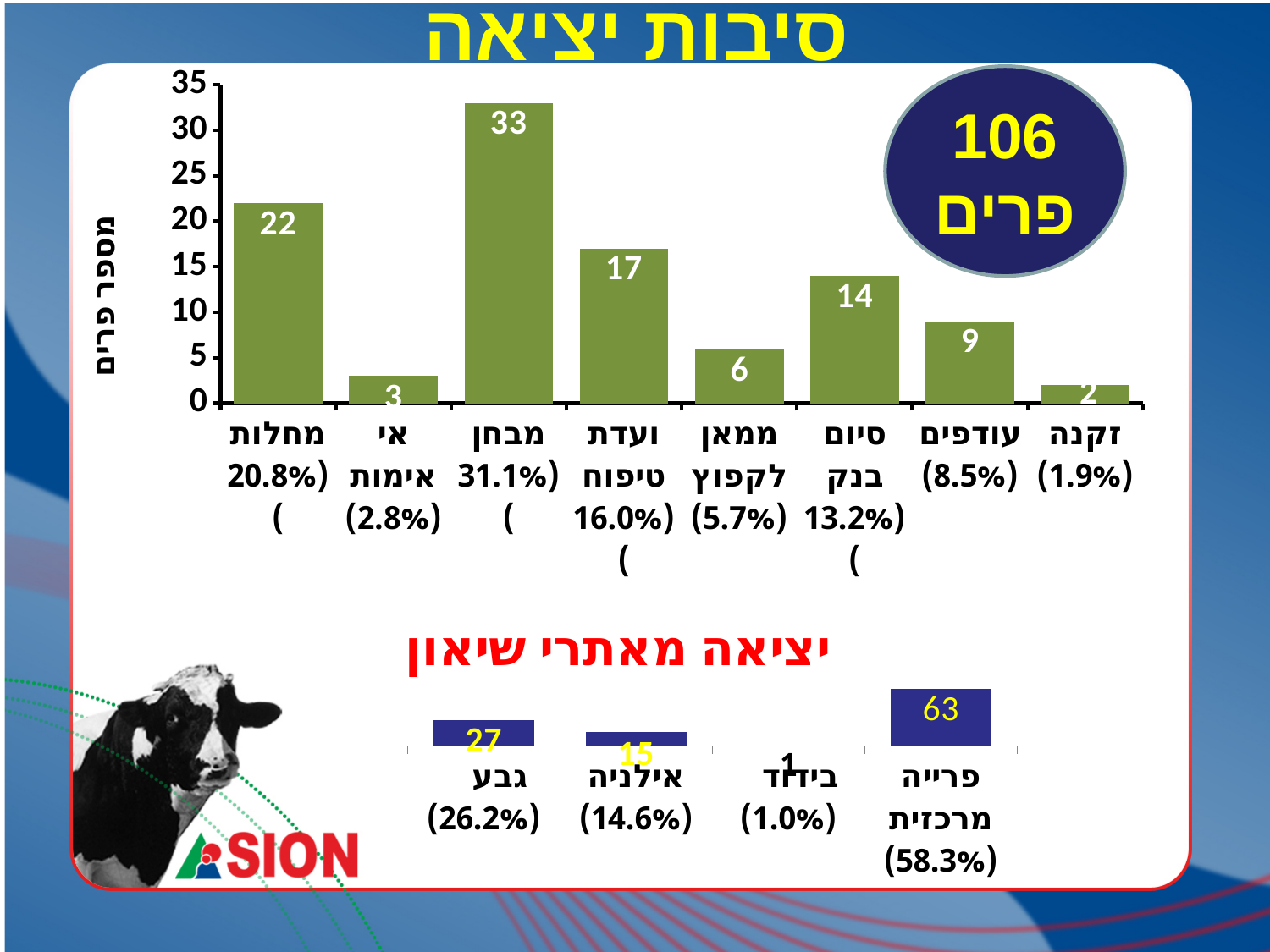
In the top chart (סיבות יציאה), what is the value for מחלות? 22 In the top chart (סיבות יציאה), which category has the lowest value? זקנה In the bottom chart (יציאה מאתרי שיאון), which category has the lowest value? בידוד In the bottom chart (יציאה מאתרי שיאון), what is the difference between the values for גבע and אילניה? 12 In the bottom chart (יציאה מאתרי שיאון), what is the value for פרייה מרכזית? 63 In the top chart (סיבות יציאה), which category has the highest value? מבחן What kind of chart is the top chart (סיבות יציאה)? Bar chart In the top chart (סיבות יציאה), what is the difference between the values for מבחן and ועדת טיפוח? 16 In the top chart (סיבות יציאה), how many categories are shown? 8 In the top chart (סיבות יציאה), what is the y-axis label? מספר פרים In the top chart (סיבות יציאה), what is the value for מבחן? 33 In the top chart (סיבות יציאה), which is larger, the value for סיום בנק or the value for עודפים? סיום בנק